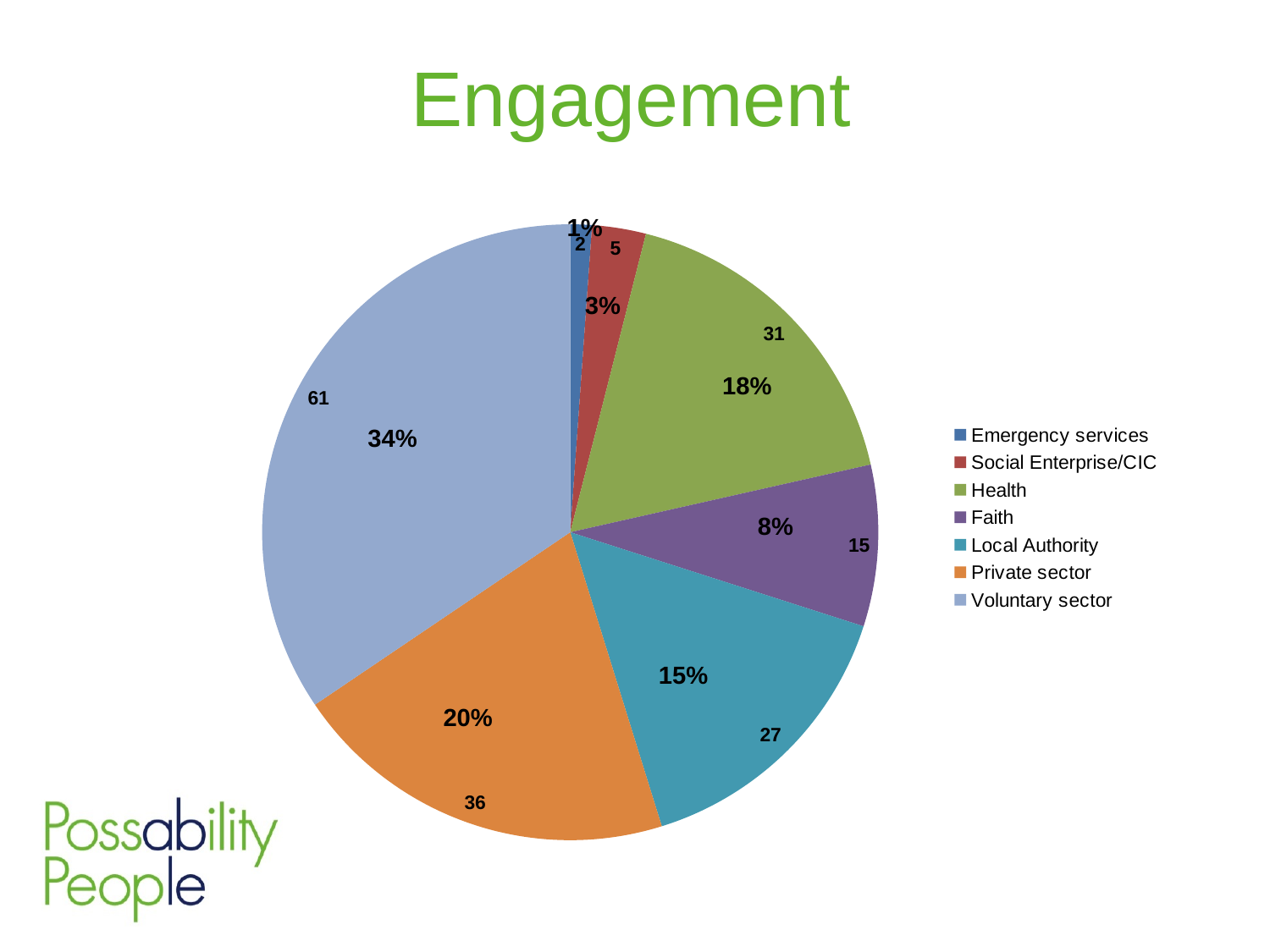
What percentage share does Private sector have? 20% What is the value for Voluntary sector? 61 What percentage share does Social Enterprise/CIC have? 3% Which category has the smallest slice? Emergency services What is the value for Local Authority? 27 Which category has the largest slice? Voluntary sector What kind of chart is shown on the slide? Pie chart How many categories does the pie chart show? 7 What percentage share does Health have? 18% Which is larger, Health or Faith? Health What is the difference between the values for Private sector and Local Authority? 9 What is the title of the slide? Engagement